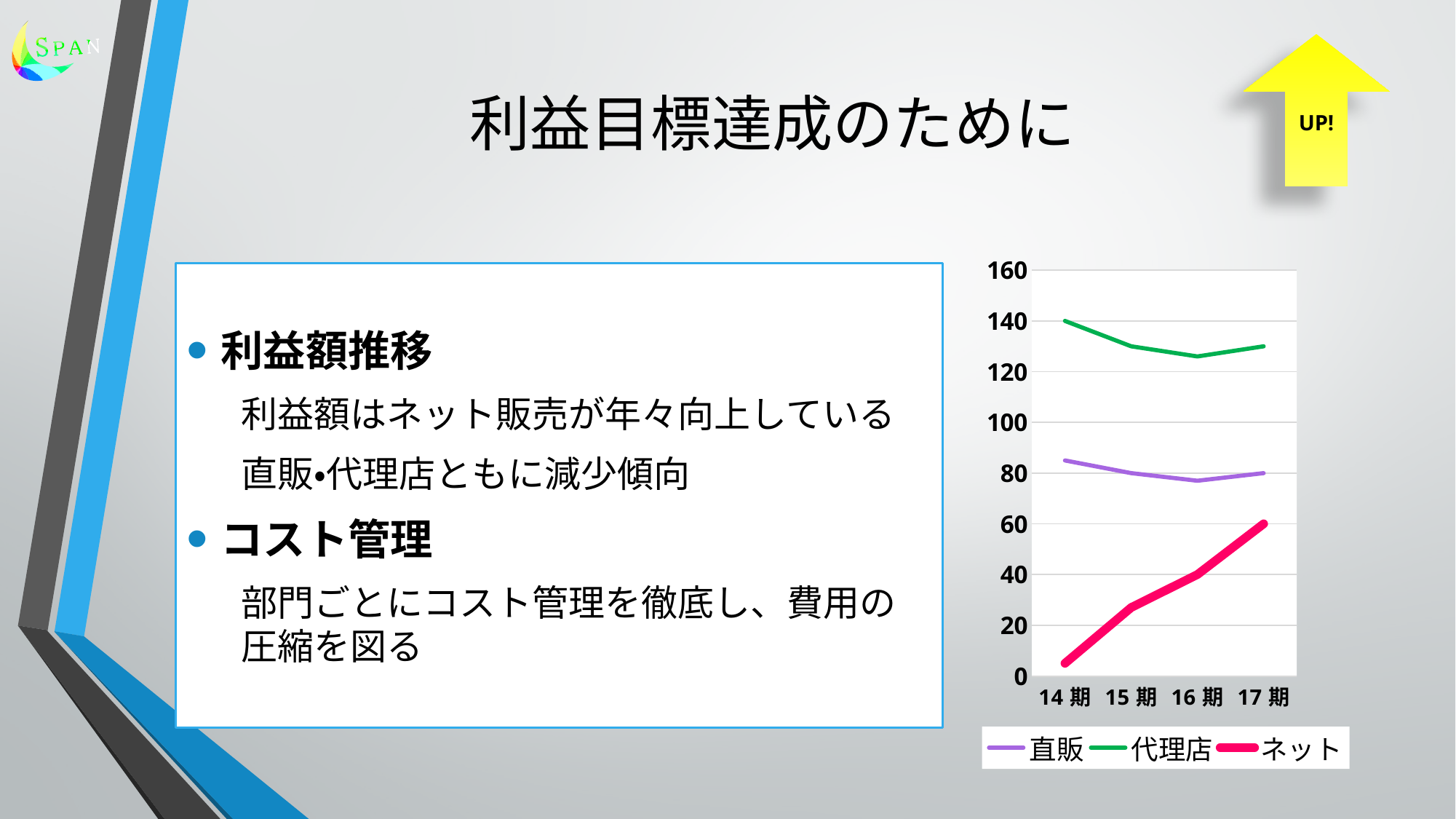
At 16期, which is larger, 直販 or ネット? 直販 How many series does the chart legend list? 3 Is the value for 代理店 at 16期 greater or less than 120? greater How many periods are shown on the x axis of the chart? 4 What is the value for 代理店 at 14期? 140 Which series has the lowest value at 17期? ネット Which series has the highest value at 14期? 代理店 Is the value for 直販 at 16期 greater or less than 80? less What kind of chart is shown on the slide? line chart Does the ネット line rise or fall from 14期 to 17期? rise Is the value for ネット at 15期 greater or less than 40? less Overall, does the 代理店 line rise or fall from 14期 to 17期? fall